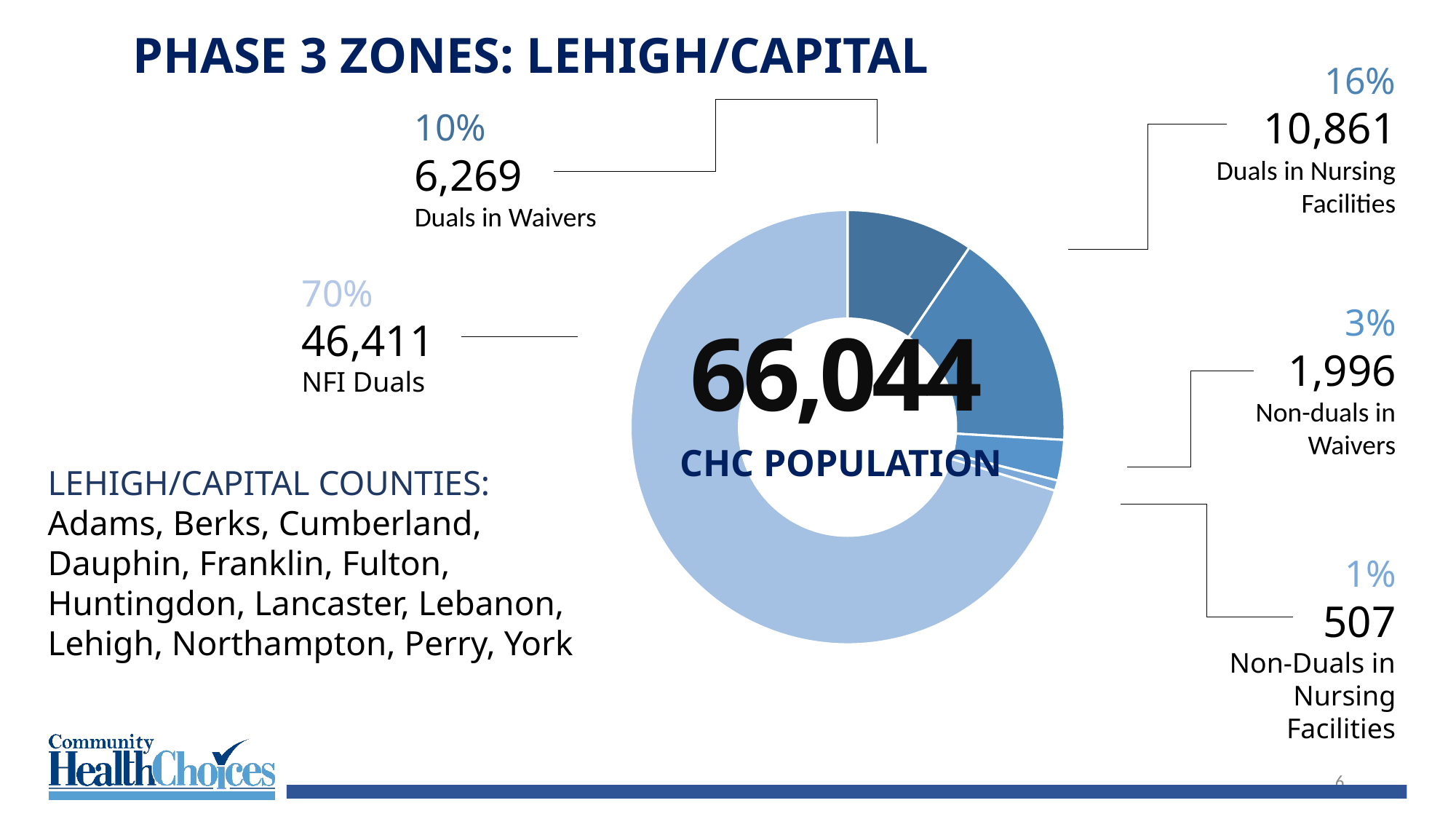
What kind of chart is shown on the slide? Pie chart (donut) How many categories are shown in the chart? 5 What percentage of the chart is Duals in Waivers? 10% What is the total CHC population shown in the centre of the chart? 66,044 Which category has the largest slice of the chart? NFI Duals What is the difference between the number of Duals in Nursing Facilities and Duals in Waivers? 4,592 Which is larger, Non-duals in Waivers or Non-Duals in Nursing Facilities? Non-duals in Waivers Which category has the smallest slice of the chart? Non-Duals in Nursing Facilities How many NFI Duals are shown on the chart? 46,411 How many Duals in Nursing Facilities are shown? 10,861 What share of the CHC population are NFI Duals? 70% How many Non-duals in Waivers are shown? 1,996